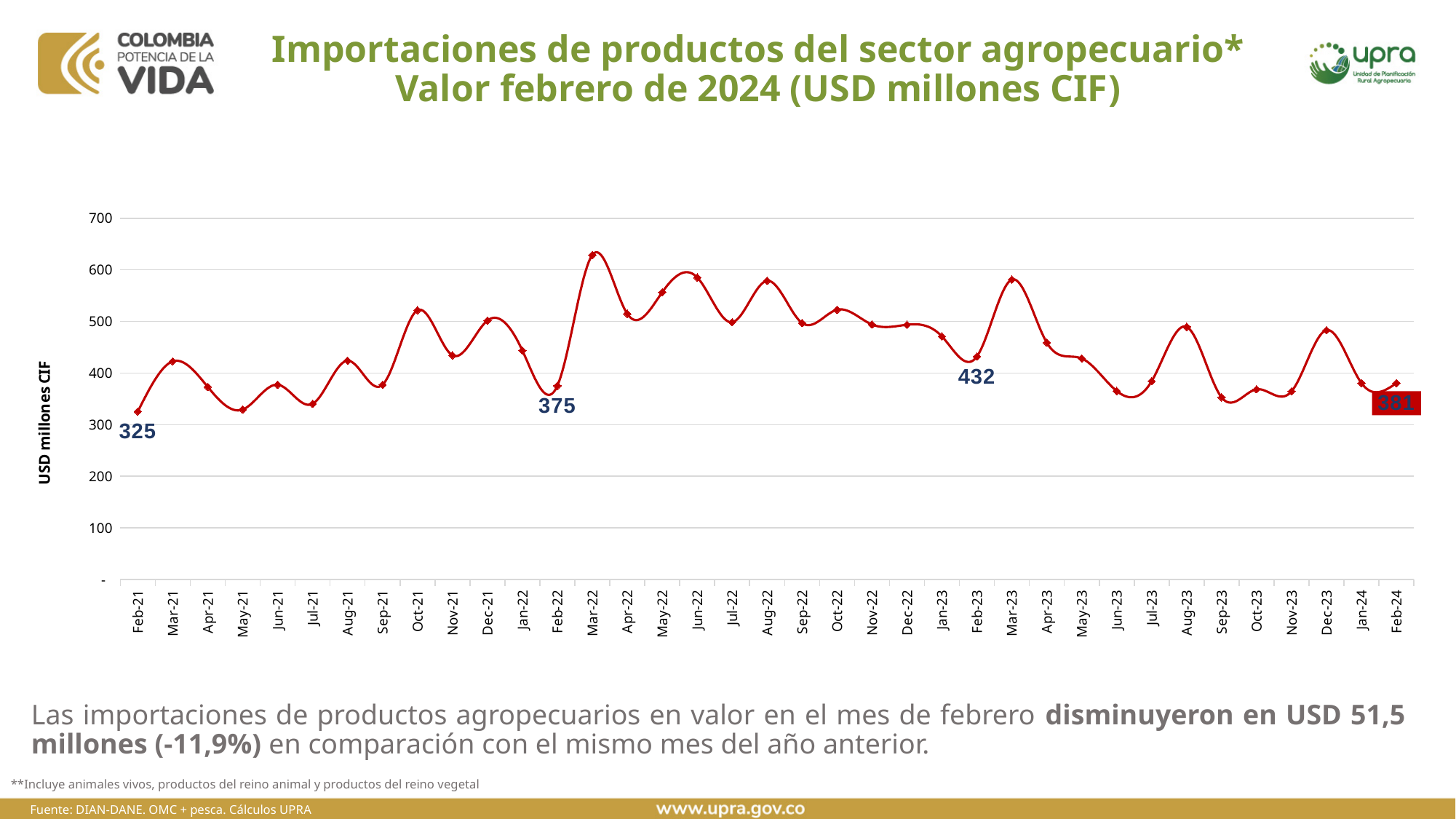
Is the value for Mar-22 greater or less than 600? greater Is the value for Jul-23 greater or less than 400? less Which month has the highest value on the chart? Mar-22 What is the value for Feb-23? 432 What is the label of the vertical axis? USD millones CIF What is the value for Feb-24? 381 What is the value for Feb-22? 375 What is the difference between the values for Feb-22 and Feb-21? 50 What is the value for Feb-21? 325 Which is larger, the value for Feb-23 or the value for Feb-24? Feb-23 What is the difference between the values for Feb-23 and Feb-24? 51 What type of chart is shown on the slide? Line chart